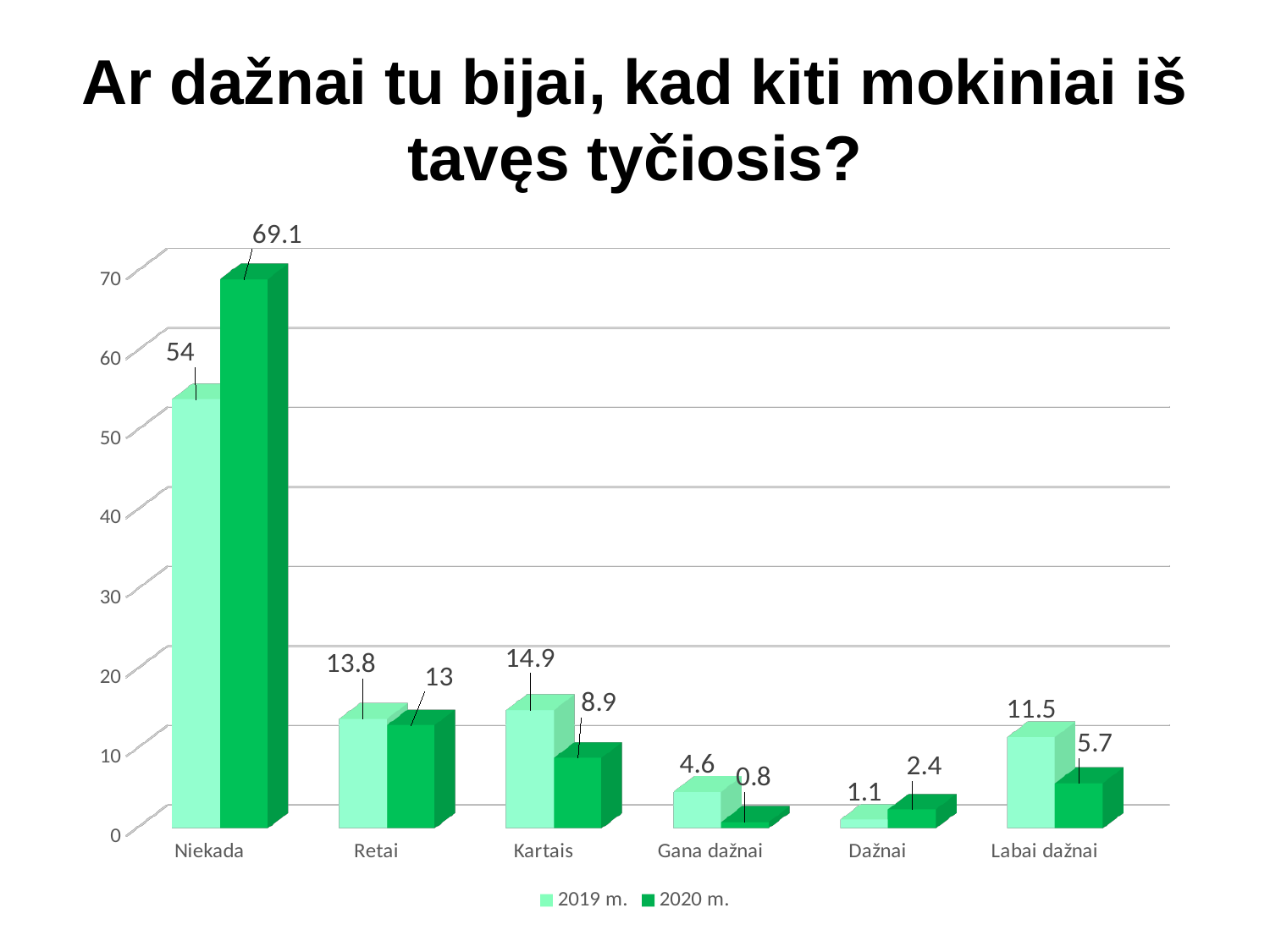
What is the difference between the 2020 m. and 2019 m. values for Niekada? 15.1 Is the 2019 m. value for Niekada greater or less than 50? greater What is the value for Kartais in the 2019 m. series? 14.9 Which is larger for Labai dažnai: the 2019 m. value or the 2020 m. value? 2019 m. How many categories are shown on the x axis? 6 What is the value for Gana dažnai in the 2020 m. series? 0.8 What kind of chart is shown on the slide? bar chart Which category has the lowest value in the 2020 m. series? Gana dažnai What is the value for Niekada in the 2020 m. series? 69.1 How many series does the legend list? 2 What is the difference between the 2019 m. and 2020 m. values for Kartais? 6 Which category has the highest value in the 2019 m. series? Niekada